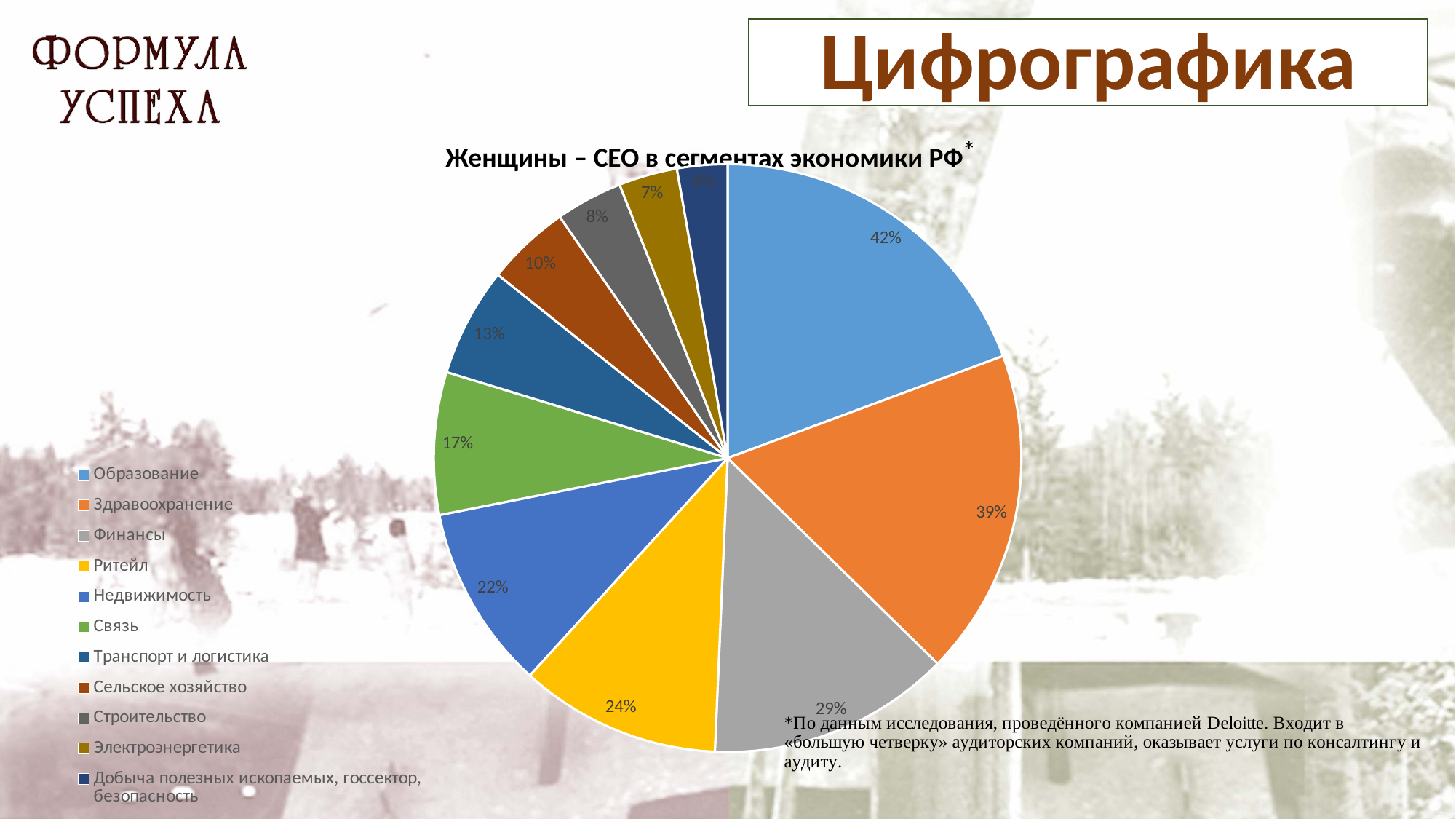
Which is larger, the value for Транспорт и логистика or the value for Строительство? Транспорт и логистика What value is shown for Образование? 42% How many categories does the legend of the pie chart list? 11 What value is shown for Здравоохранение? 39% What kind of chart is shown on the slide? pie chart Which category has the smallest slice in the pie chart? Добыча полезных ископаемых, госсектор, безопасность What is the title of the chart? Женщины – CEO в сегментах экономики РФ Which category has the largest slice in the pie chart? Образование What value is shown for Связь? 17% What value is shown for Ритейл? 24% What is the difference between the values for Финансы and Недвижимость? 7% What value is shown for Сельское хозяйство? 10%